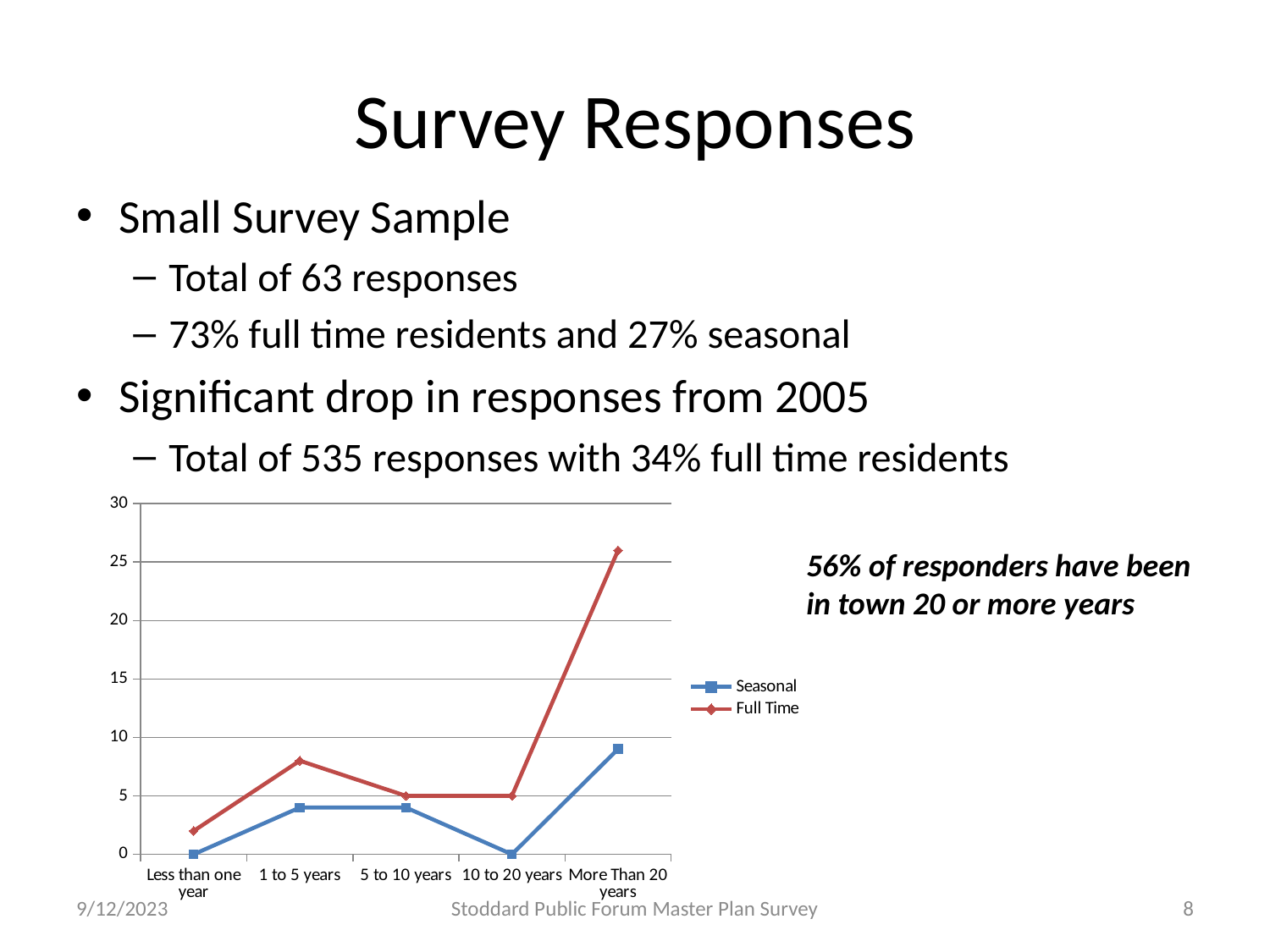
Is the Full Time value for 1 to 5 years greater or less than 5? greater What is the Seasonal value for 10 to 20 years? 0 What is the Full Time value for 5 to 10 years? 5 Is the Full Time value for More Than 20 years greater or less than 25? greater At 1 to 5 years, which series has the larger value, Seasonal or Full Time? Full Time How many categories are shown along the x axis of the chart? 5 Is the Seasonal value for More Than 20 years greater or less than 10? less Which category has the highest Seasonal value? More Than 20 years Does the Full Time line rise or fall from 10 to 20 years to More Than 20 years? rise How many series does the chart's legend list? 2 What kind of chart is shown on the slide? line chart Which category has the highest Full Time value? More Than 20 years